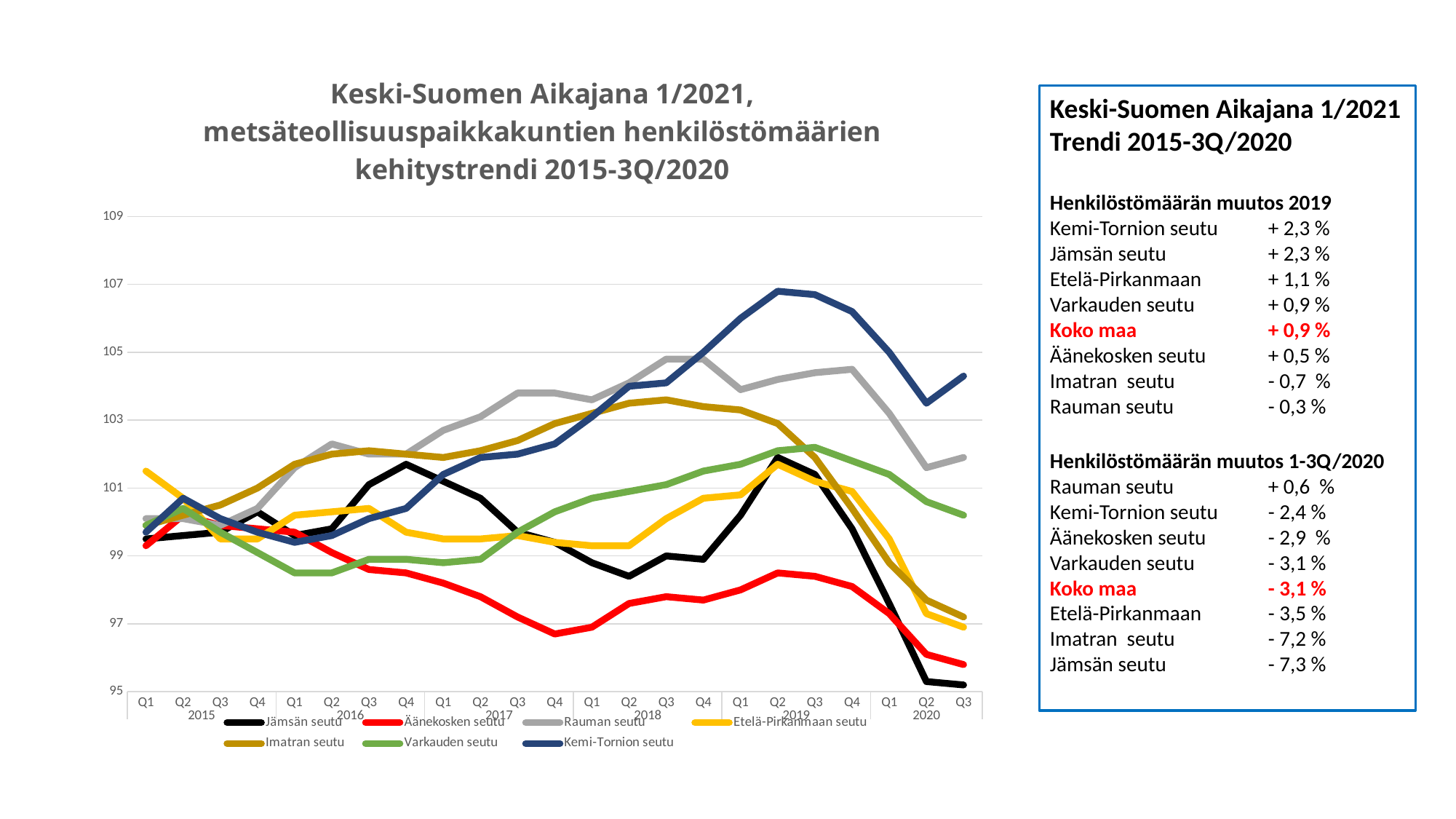
Does the Äänekosken seutu line overall rise or fall from Q1 2015 to Q3 2020? fall At Q4 2019, which is larger: the value for Kemi-Tornion seutu or the value for Rauman seutu? Kemi-Tornion seutu Which series has the lowest value at Q4 2017? Äänekosken seutu Which colour is used for the Kemi-Tornion seutu line in the chart? dark blue How many quarterly points are plotted along the x axis of the chart? 23 What kind of chart is shown on the slide? line chart Is the value for Rauman seutu at Q3 2018 greater or less than 103? greater Is the value for Kemi-Tornion seutu at Q2 2019 greater or less than 105? greater How many series does the chart's legend list? 7 Which series has the highest value at Q2 2019? Kemi-Tornion seutu Is the value for Jämsän seutu at Q3 2020 greater or less than 97? less